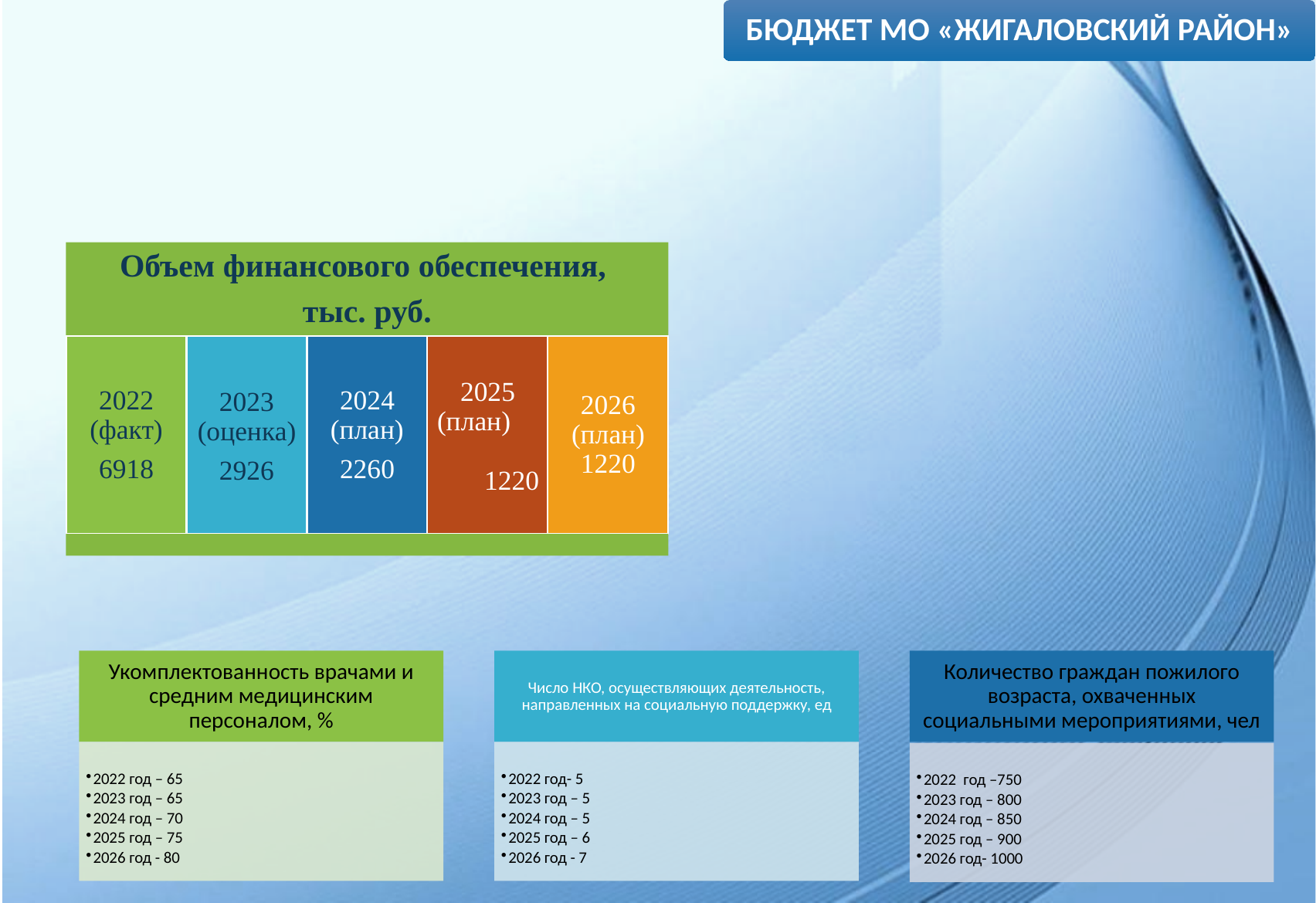
How many years are shown in the "Объем финансового обеспечения, тыс. руб." block? 5 What unit is stated in the title of the "Объем финансового обеспечения" block? тыс. руб. In the "Объем финансового обеспечения, тыс. руб." block, what colour is the 2025 (план) column? dark orange (brown-red) In the "Объем финансового обеспечения, тыс. руб." block, what is the difference between the 2022 (факт) and 2023 (оценка) values? 3992 In the "Объем финансового обеспечения, тыс. руб." block, what is the value for 2022 (факт)? 6918 In the "Объем финансового обеспечения, тыс. руб." block, what is the value for 2025 (план)? 1220 In the "Объем финансового обеспечения, тыс. руб." block, what is the value for 2024 (план)? 2260 In the "Объем финансового обеспечения, тыс. руб." block, what is the difference between the 2024 (план) and 2025 (план) values? 1040 In the "Объем финансового обеспечения, тыс. руб." block, what is the value for 2023 (оценка)? 2926 In the "Объем финансового обеспечения, тыс. руб." block, which is larger: the value for 2023 (оценка) or 2024 (план)? 2023 (оценка) In the "Объем финансового обеспечения, тыс. руб." block, do the values rise or fall from 2022 to 2026? fall In the "Объем финансового обеспечения, тыс. руб." block, which year has the highest value? 2022 (факт)